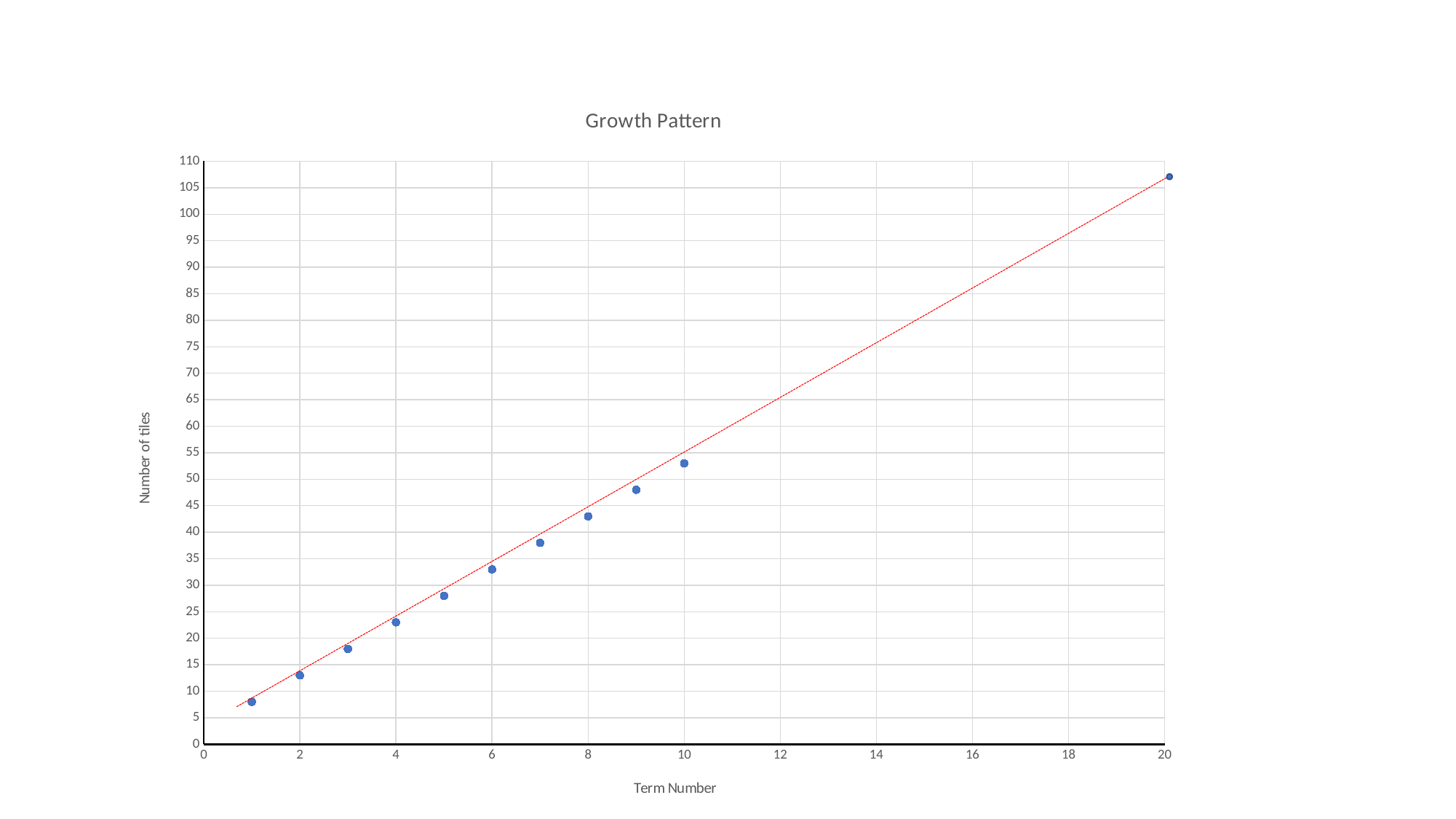
What is the label of the x axis? Term Number Is the number of tiles for term 5 greater or less than 30? less What is the title of the chart? Growth Pattern Do the values rise or fall as the term number increases? rise Which term number has the lowest number of tiles? 1 Which term number has the highest number of tiles? 20 Is the number of tiles for term 10 greater or less than 50? greater Is the number of tiles for term 1 greater or less than 10? less What kind of chart is shown on the slide? scatter chart Which has more tiles, term 10 or term 5? term 10 How many data points are plotted on the chart? 11